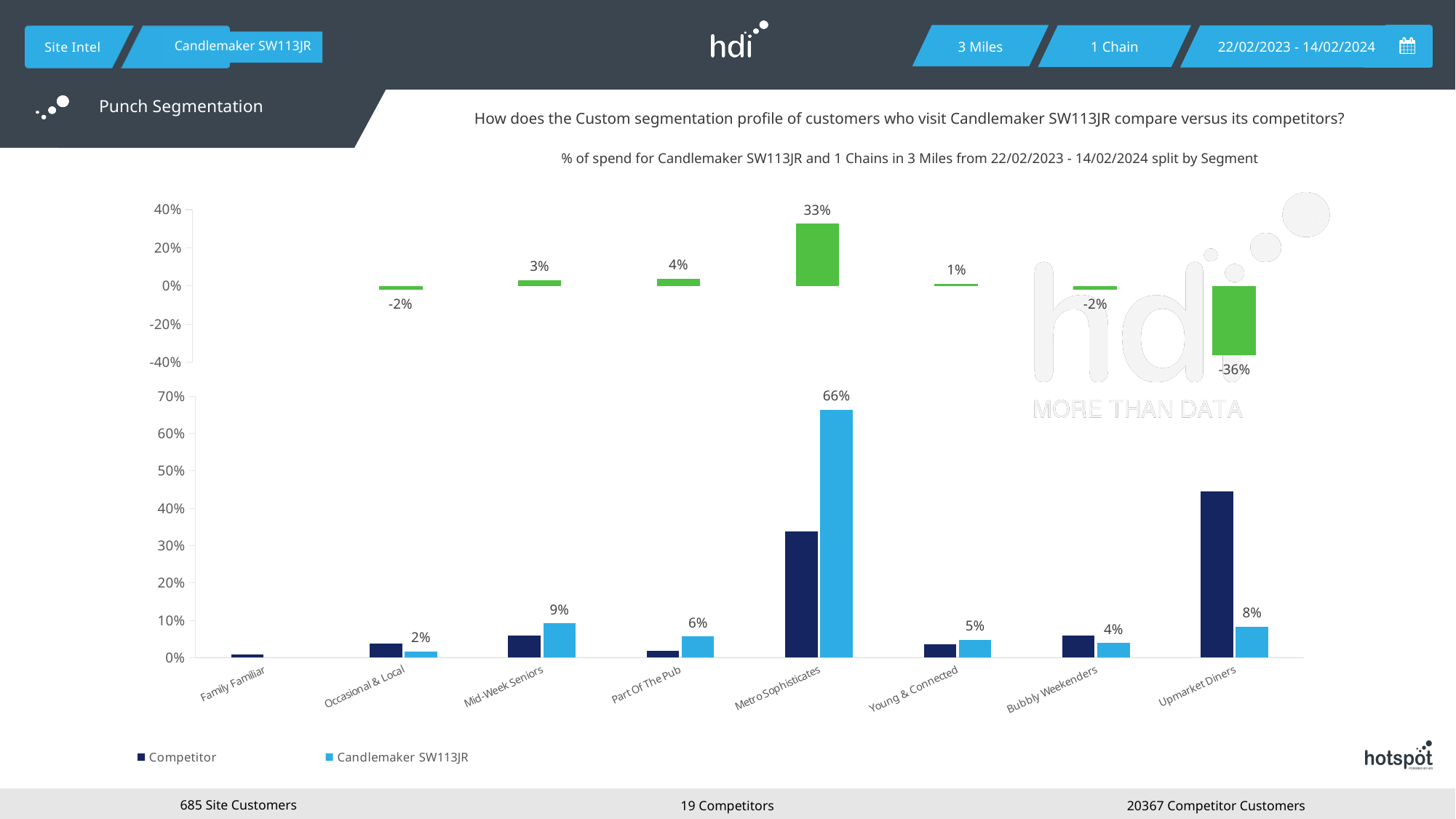
How many segment categories are shown on the x axis of the bottom chart? 8 In the bottom chart, is the Competitor value for Metro Sophisticates greater or less than 30%? greater How many series does the legend of the bottom chart list? 2 In the top chart, what is the value shown for Metro Sophisticates? 33% In the bottom chart, what is the Candlemaker SW113JR value for Metro Sophisticates? 66% What kind of chart is the bottom chart? bar chart In the bottom chart, what is the Candlemaker SW113JR value for Mid-Week Seniors? 9% In the top chart, which segment has the lowest value? Upmarket Diners In the top chart, what is the value shown for Upmarket Diners? -36% In the bottom chart, is the Competitor value for Upmarket Diners greater or less than 40%? greater In the top chart, which segment has the highest value? Metro Sophisticates In the bottom chart, for Upmarket Diners, which is larger: the Competitor value or the Candlemaker SW113JR value? Competitor